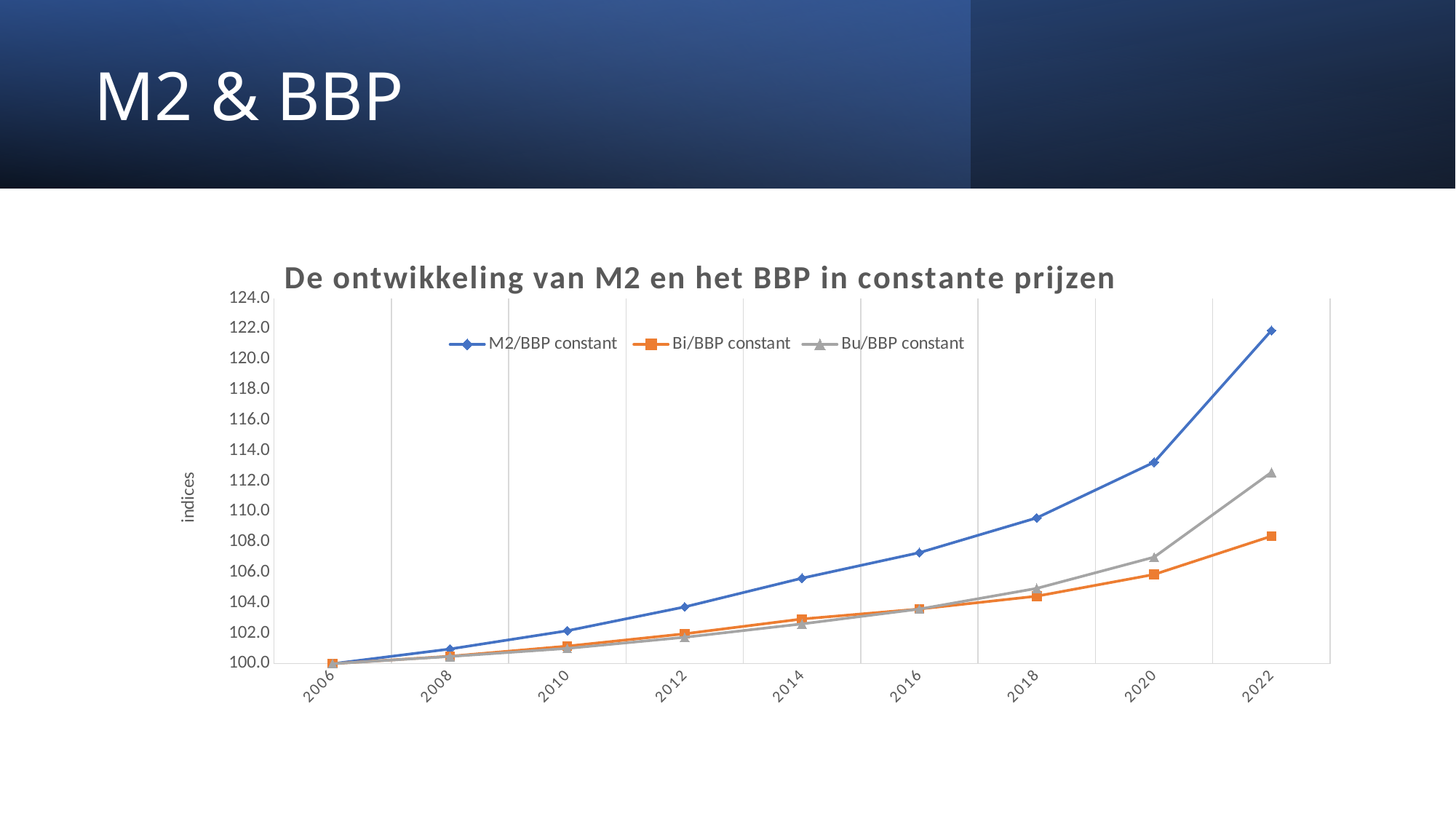
Which series has the lowest value in 2022? Bi/BBP constant Do the values of M2/BBP constant rise or fall from 2006 to 2022? rise What kind of chart is shown on the slide? line chart Is the value for Bi/BBP constant in 2022 greater or less than 110.0? less How many years are marked along the x axis? 9 What is the title of the chart? De ontwikkeling van M2 en het BBP in constante prijzen Which series has the highest value in 2022? M2/BBP constant What is the value of M2/BBP constant in 2006? 100.0 What is the label on the y axis? indices How many series does the legend list? 3 Is the value for M2/BBP constant in 2022 greater or less than 120.0? greater In 2022, which is larger: Bu/BBP constant or Bi/BBP constant? Bu/BBP constant